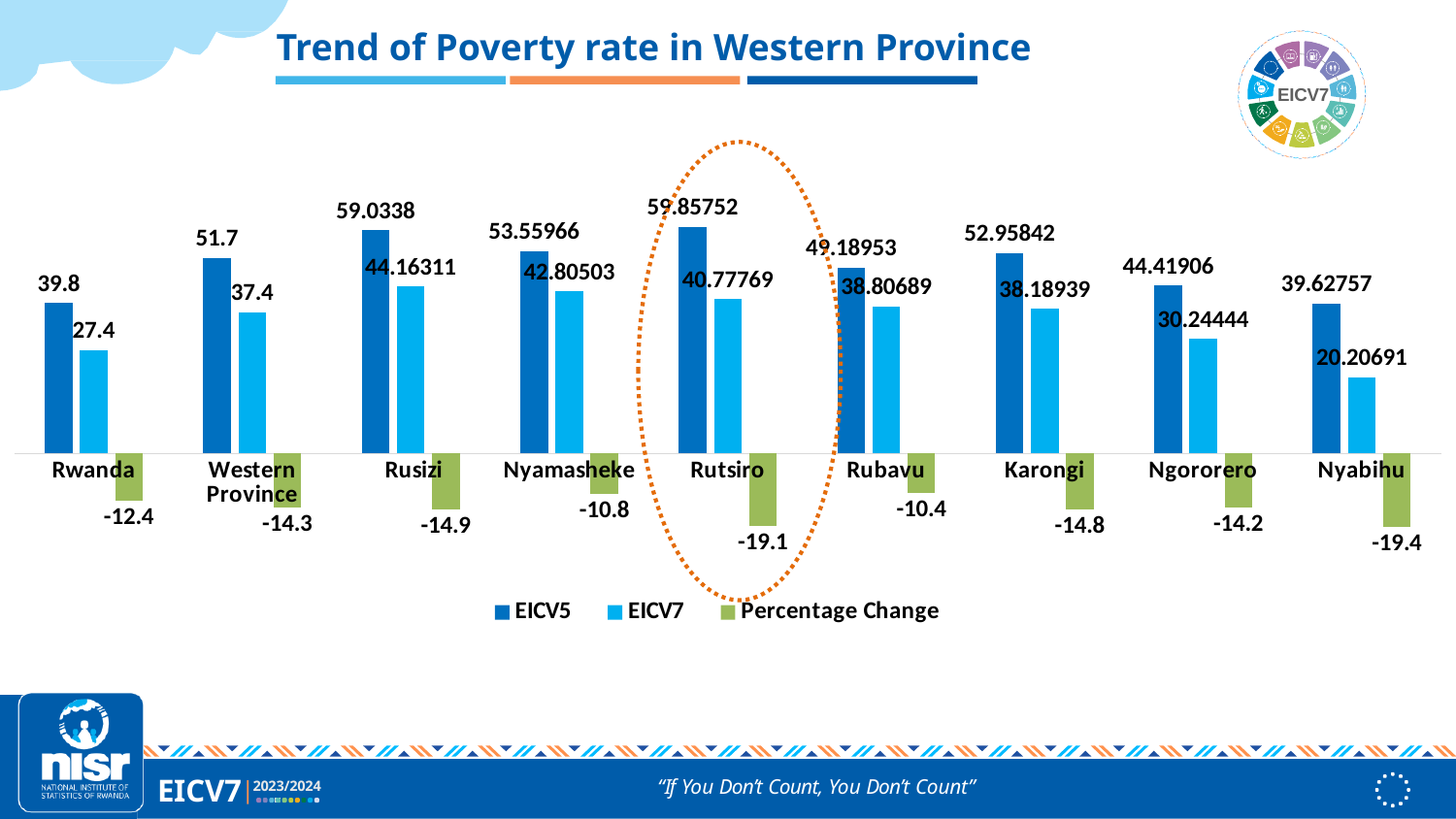
Which category has the highest EICV5 poverty rate? Rutsiro What is the title of the chart? Trend of Poverty rate in Western Province What is the EICV7 poverty rate for Karongi? 38.18939 How many series does the legend list? 3 What is the Percentage Change value for Western Province? -14.3 What kind of chart is shown on the slide? Bar chart What is the EICV7 poverty rate for Nyabihu? 20.20691 What is the difference between the EICV5 and EICV7 poverty rates for Rwanda? 12.4 What is the EICV5 poverty rate for Rutsiro? 59.85752 Which category has the lowest EICV7 poverty rate? Nyabihu Which is larger, the EICV7 poverty rate for Rusizi or for Nyamasheke? Rusizi How many categories are shown on the x axis of the chart? 9